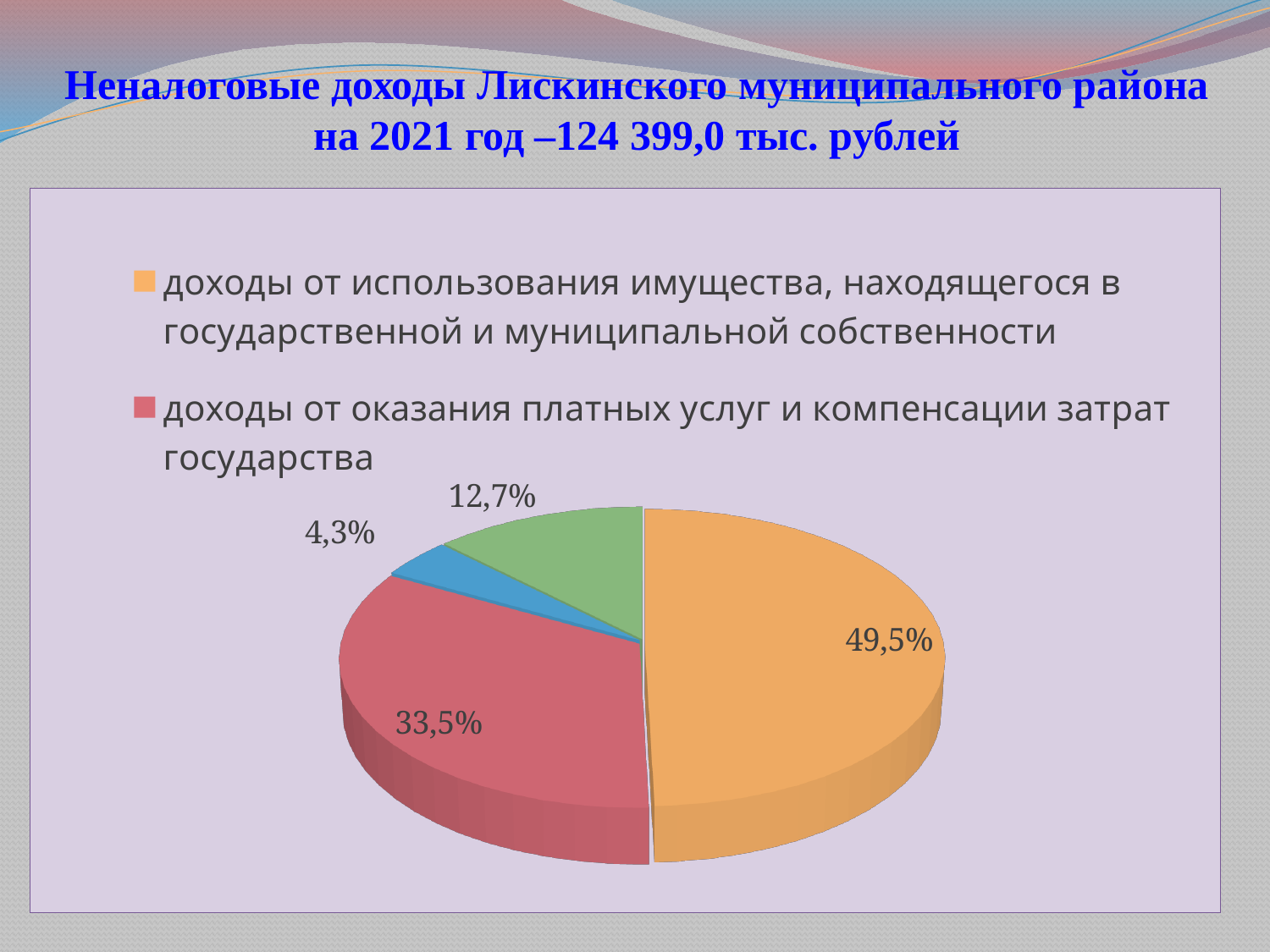
What is the difference in percentage points between the slice for "доходы от использования имущества" (49,5%) and the slice for "доходы от оказания платных услуг и компенсации затрат государства" (33,5%)? 16 percentage points What colour is the slice for "доходы от оказания платных услуг и компенсации затрат государства"? red Which is larger: the green slice or the blue slice? the green slice What percentage is shown on the blue slice of the pie? 4,3% Which slice of the pie is the largest? доходы от использования имущества, находящегося в государственной и муниципальной собственности What percentage is shown on the green slice of the pie? 12,7% What is the smallest percentage shown on the pie chart? 4,3% What total amount of non-tax revenue for 2021 is stated in the slide title? 124 399,0 тыс. рублей What kind of chart is shown on the slide? pie chart How many slices does the pie chart have? 4 What share of the pie does the slice for "доходы от оказания платных услуг и компенсации затрат государства" have? 33,5% What share of the pie does the slice for "доходы от использования имущества, находящегося в государственной и муниципальной собственности" have? 49,5%